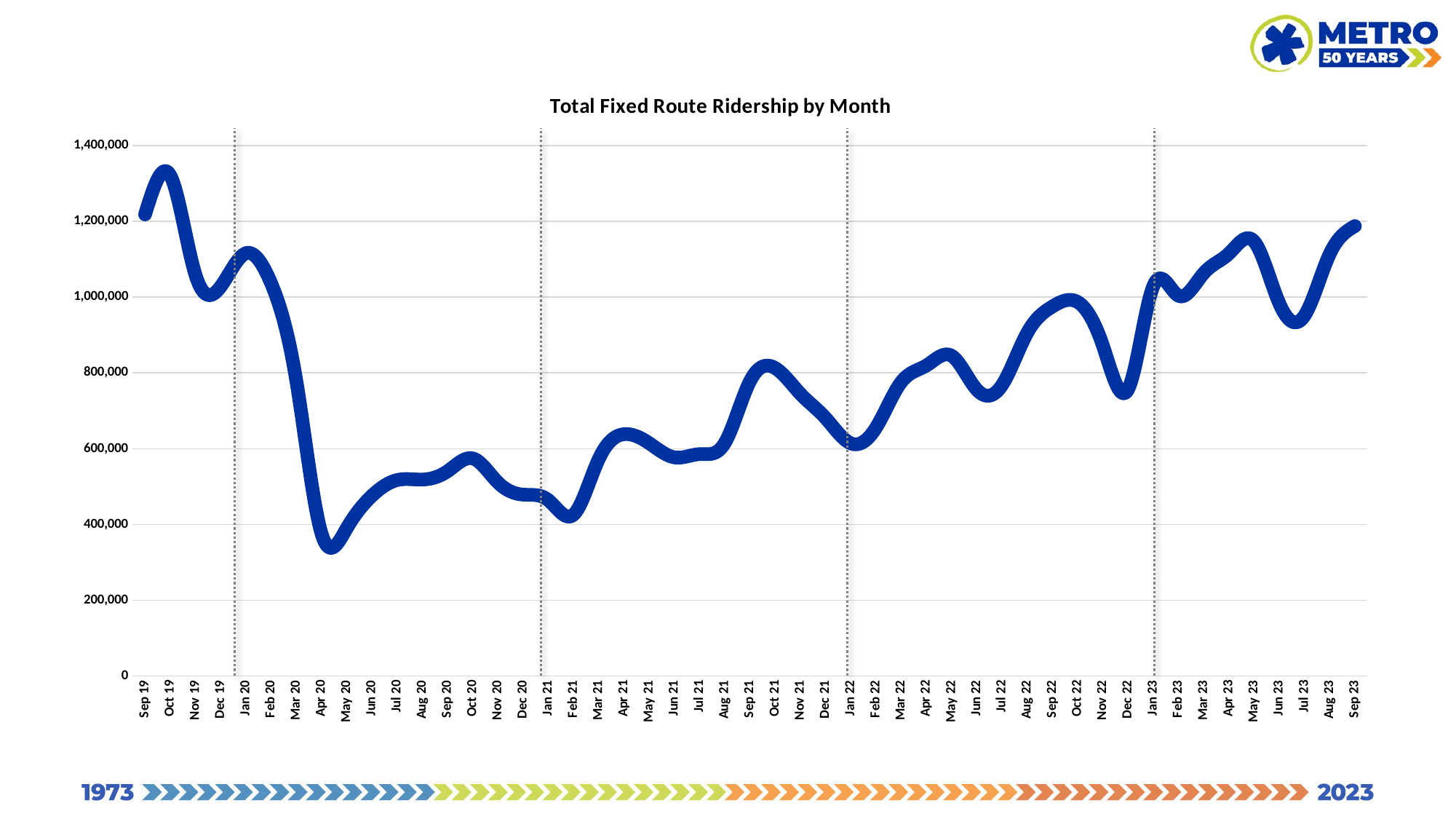
How many dotted vertical lines divide the chart? 4 Does ridership rise or fall between Jan 20 and Apr 20? Fall Which is larger, the ridership in Oct 19 or in Sep 23? Oct 19 How many months are plotted along the x axis of the chart? 49 Is the value for Apr 20 greater or less than 400,000? less What is the title of the chart? Total Fixed Route Ridership by Month Is the value for Oct 19 greater or less than 1,200,000? greater Is the value for May 23 greater or less than 1,000,000? greater Which month has the lowest ridership on the chart? Apr 20 What kind of chart is shown on the slide? Line chart Which month has the highest ridership on the chart? Oct 19